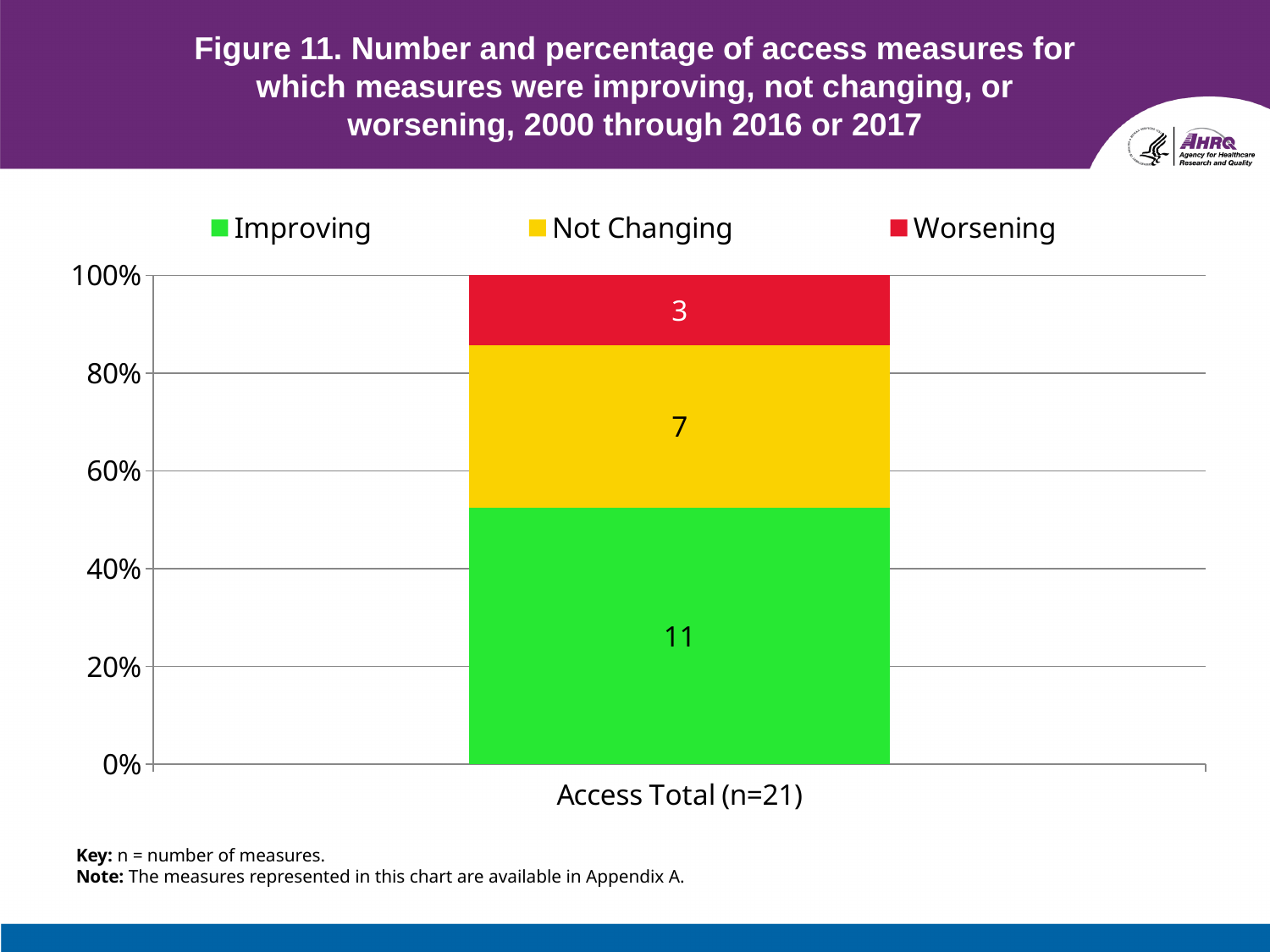
Which is larger, the number of not changing measures or the number of worsening measures? Not Changing How many access measures were not changing? 7 Which series has the largest number of measures? Improving What is the difference between the number of improving measures and the number of worsening measures? 8 How many access measures were worsening? 3 Which series has the smallest number of measures? Worsening How many series does the legend list? 3 What colour represents the Worsening series? Red Is the share of improving measures greater or less than 40%? greater How many access measures were improving? 11 What kind of chart is shown on the slide? Stacked bar chart What is the total number of measures in the Access Total bar? 21